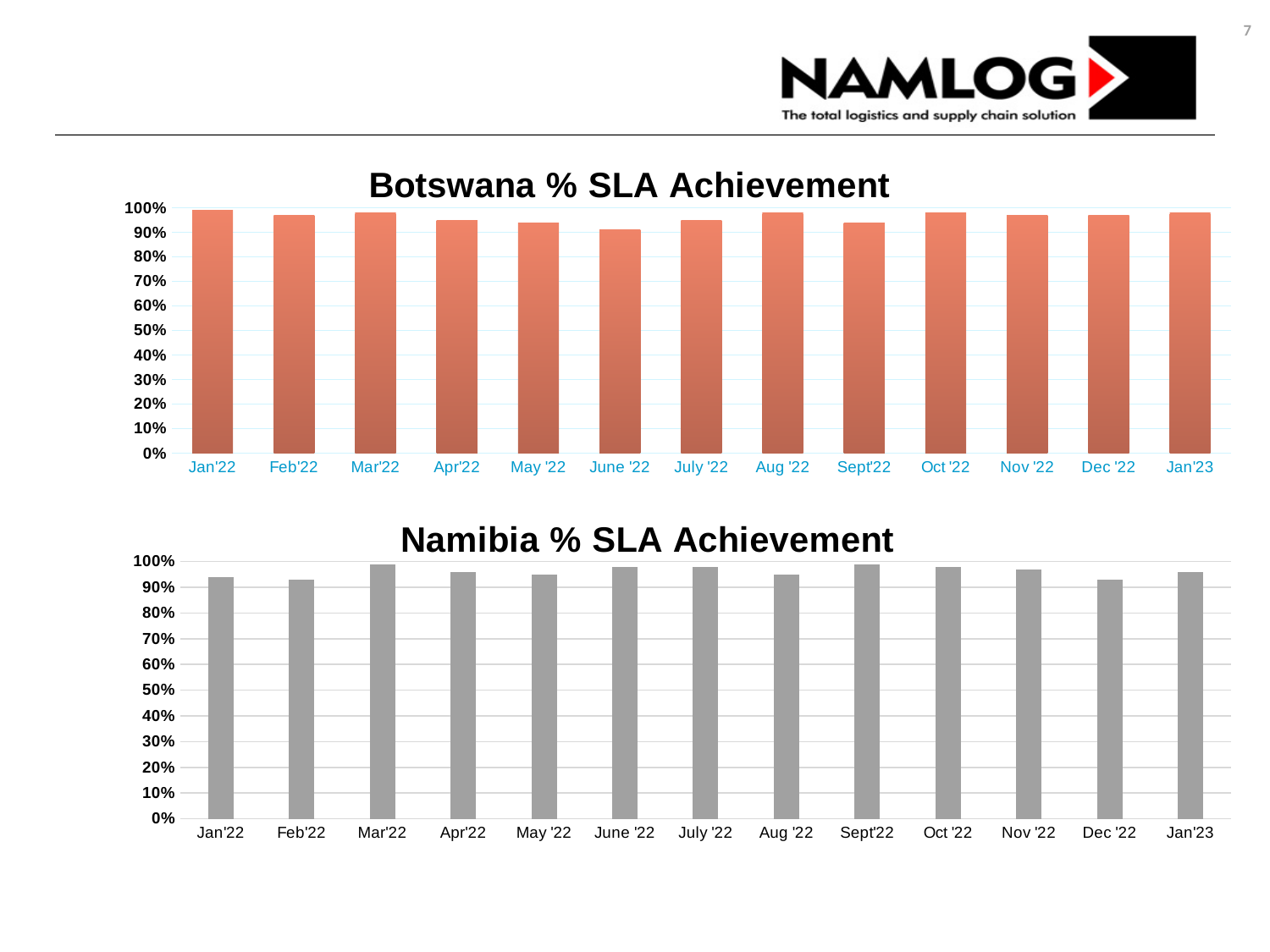
In the Botswana % SLA Achievement chart, which is larger, the value for Jan'22 or the value for June '22? Jan'22 How many months are shown on the x axis of the Namibia % SLA Achievement chart? 13 What colour are the bars in the Namibia % SLA Achievement chart? grey In the Botswana % SLA Achievement chart, which month has the lowest value? June '22 What type of chart is the Botswana % SLA Achievement chart? bar chart In the Namibia % SLA Achievement chart, is the value for Mar'22 greater or less than 90%? greater What type of chart is the Namibia % SLA Achievement chart? bar chart In the Namibia % SLA Achievement chart, which is larger, the value for Mar'22 or the value for Feb'22? Mar'22 How many months are shown on the x axis of the Botswana % SLA Achievement chart? 13 What is the title of the top chart on the slide? Botswana % SLA Achievement In the Botswana % SLA Achievement chart, is the value for Jan'22 greater or less than 90%? greater In the Namibia % SLA Achievement chart, is the value for Dec '22 greater or less than 80%? greater